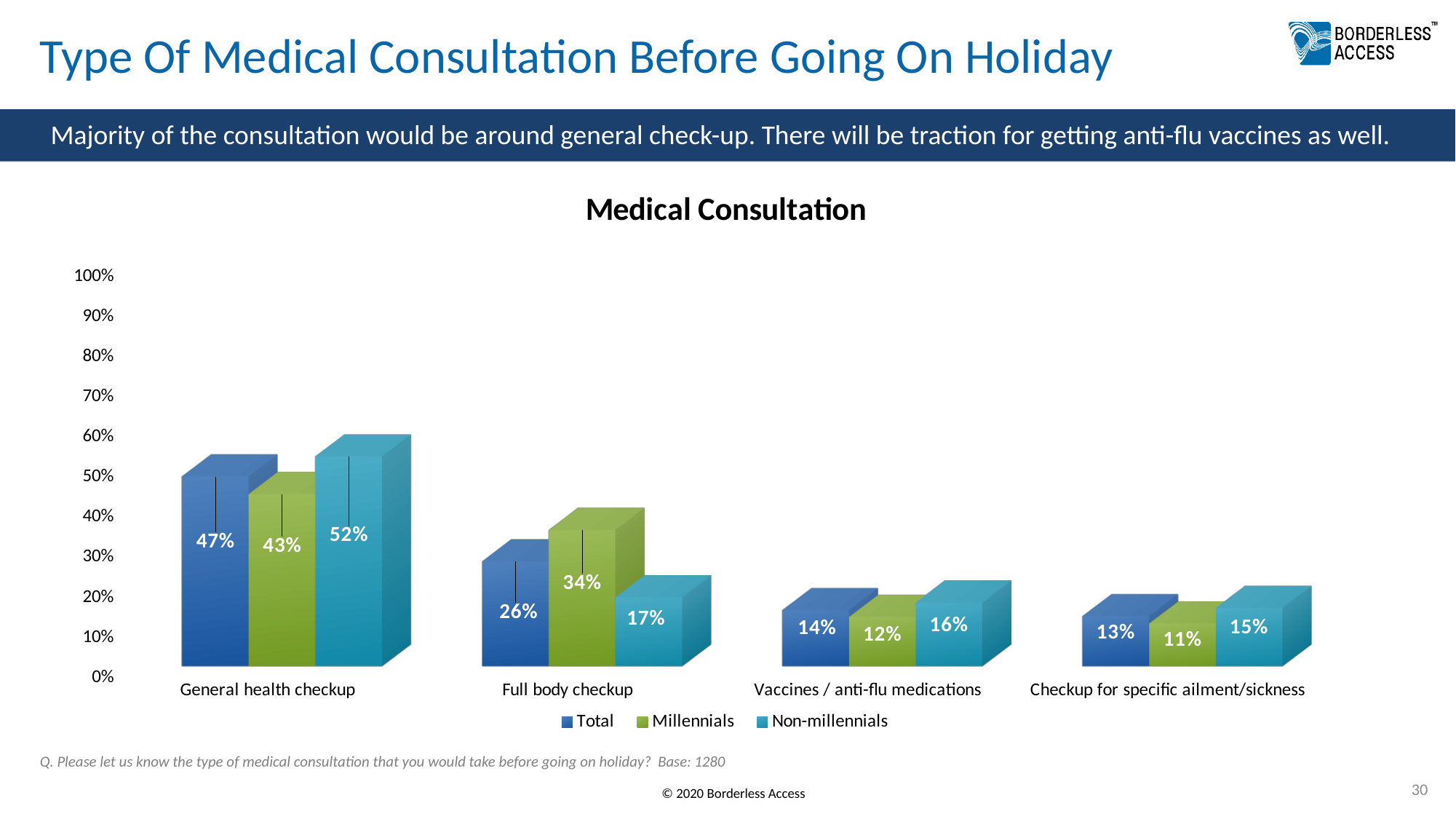
Which category has the lowest Millennials value? Checkup for specific ailment/sickness What is the Millennials value for Full body checkup? 34% Which category has the highest Total value? General health checkup What is the Non-millennials value for Vaccines / anti-flu medications? 16% What is the difference between the Non-millennials and Millennials values for General health checkup? 9% How many categories are shown on the x axis? 4 How many series does the legend list? 3 What is the Millennials value for Checkup for specific ailment/sickness? 11% What is the title of the chart? Medical Consultation What is the Total value for General health checkup? 47% For Full body checkup, which is larger: the Millennials value or the Non-millennials value? Millennials What kind of chart is shown on the slide? Bar chart